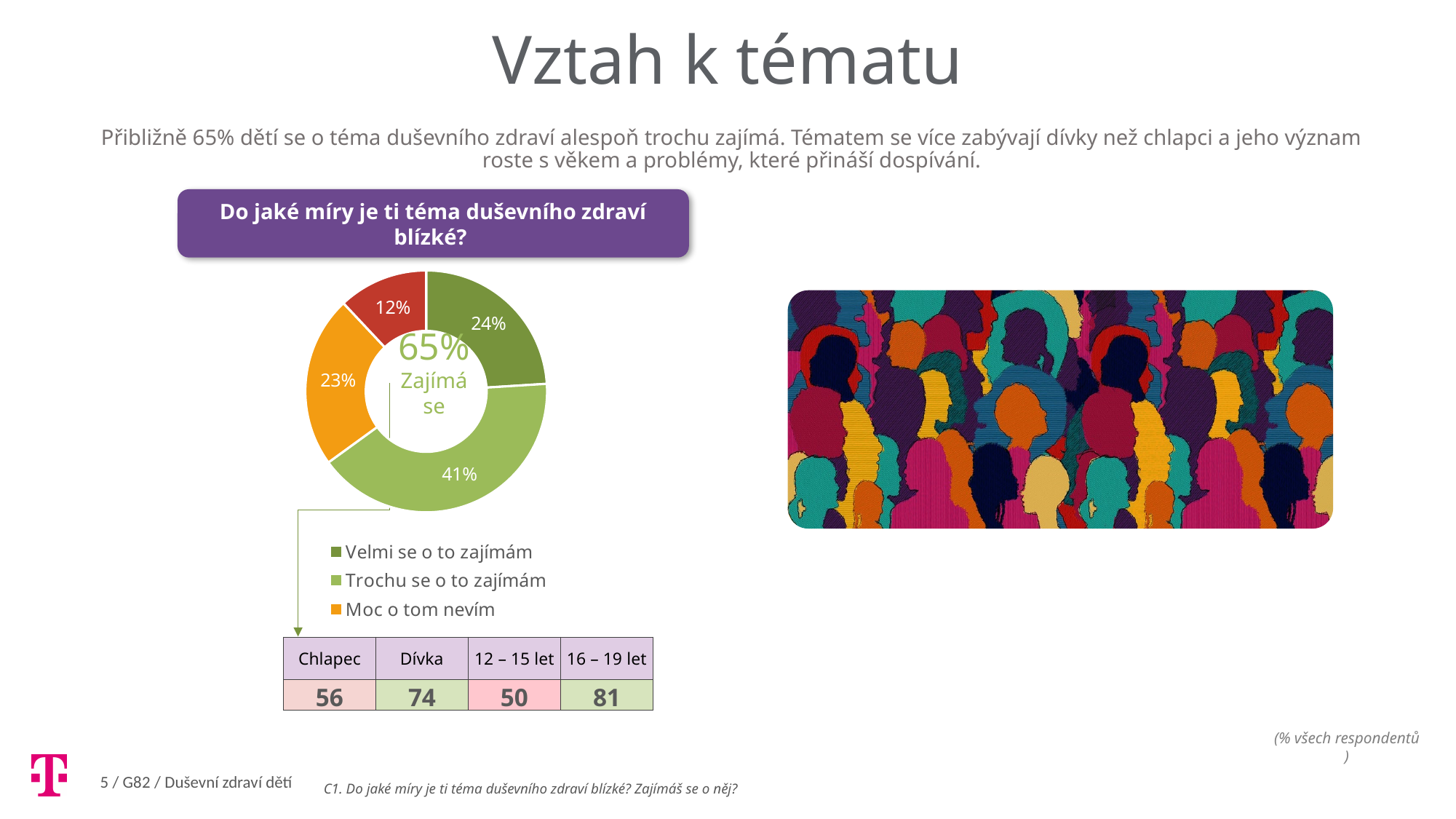
What is the smallest percentage shown on the donut chart? 12% How many entries does the legend list? 3 What is the difference between the "Trochu se o to zajímám" slice and the "Velmi se o to zajímám" slice? 17 percentage points What percentage is shown for the slice "Moc o tom nevím"? 23% In the table below the chart, what value is shown for "Dívka"? 74 How many slices does the donut chart have? 4 What percentage is shown for the slice "Velmi se o to zajímám"? 24% What combined percentage is shown in the centre of the donut chart for "Zajímá se"? 65% What percentage is shown for the slice "Trochu se o to zajímám"? 41% Which is larger: the "Velmi se o to zajímám" slice or the "Moc o tom nevím" slice? Velmi se o to zajímám What kind of chart is shown on the slide? Pie (donut) chart Which slice of the donut chart is the largest? Trochu se o to zajímám (41%)